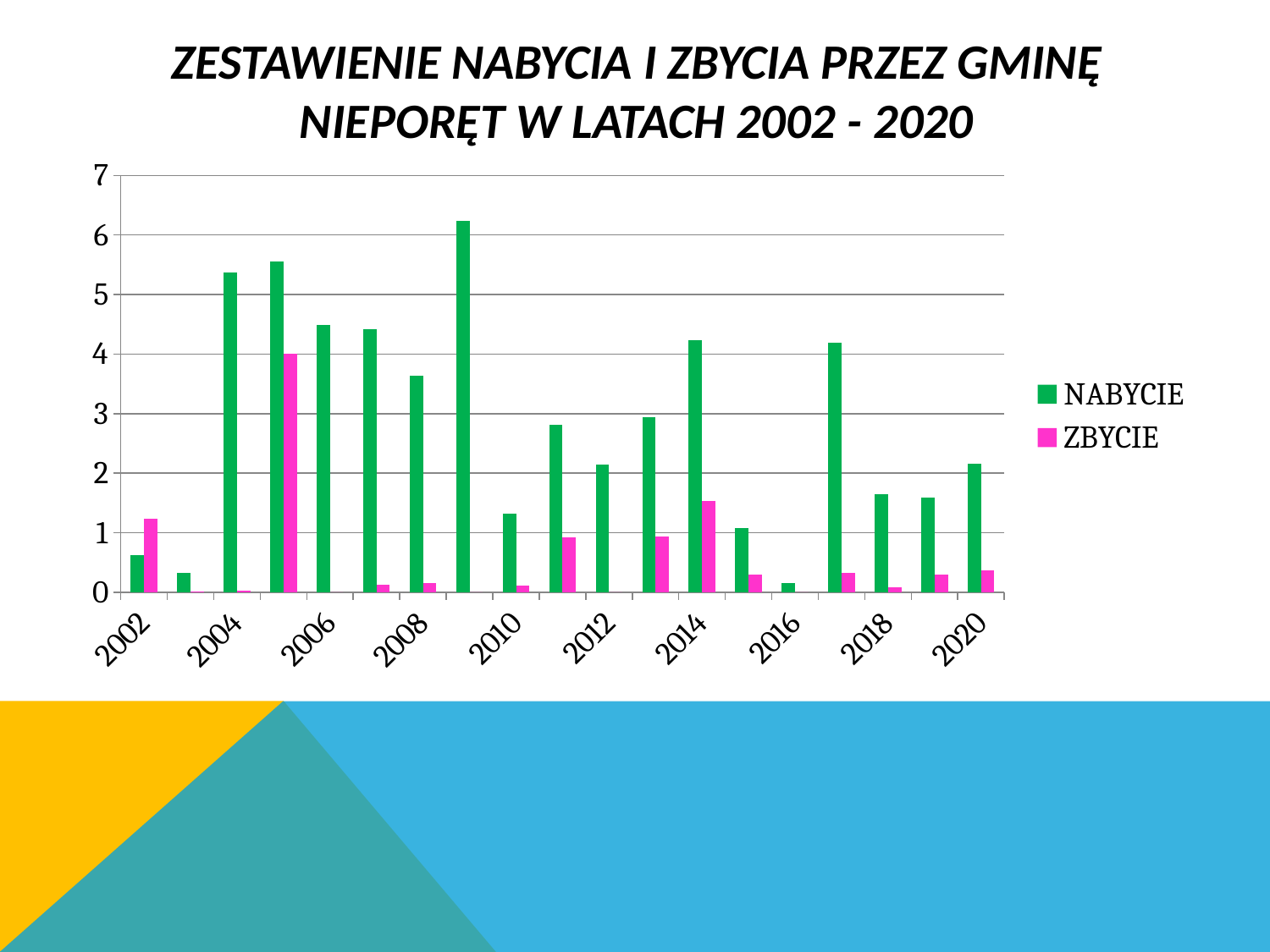
Is the NABYCIE value for 2002 greater or less than 1? less Is the NABYCIE value for 2008 greater or less than 3? greater Is the ZBYCIE value for 2014 greater or less than 1? greater How many years (categories) are plotted on the x axis, from 2002 to 2020? 19 In 2014, which is larger, NABYCIE or ZBYCIE? NABYCIE What kind of chart is shown on the slide? bar chart What are the two series named in the legend? NABYCIE and ZBYCIE What colour are the NABYCIE bars? green In 2002, which is larger, NABYCIE or ZBYCIE? ZBYCIE How many series does the legend list? 2